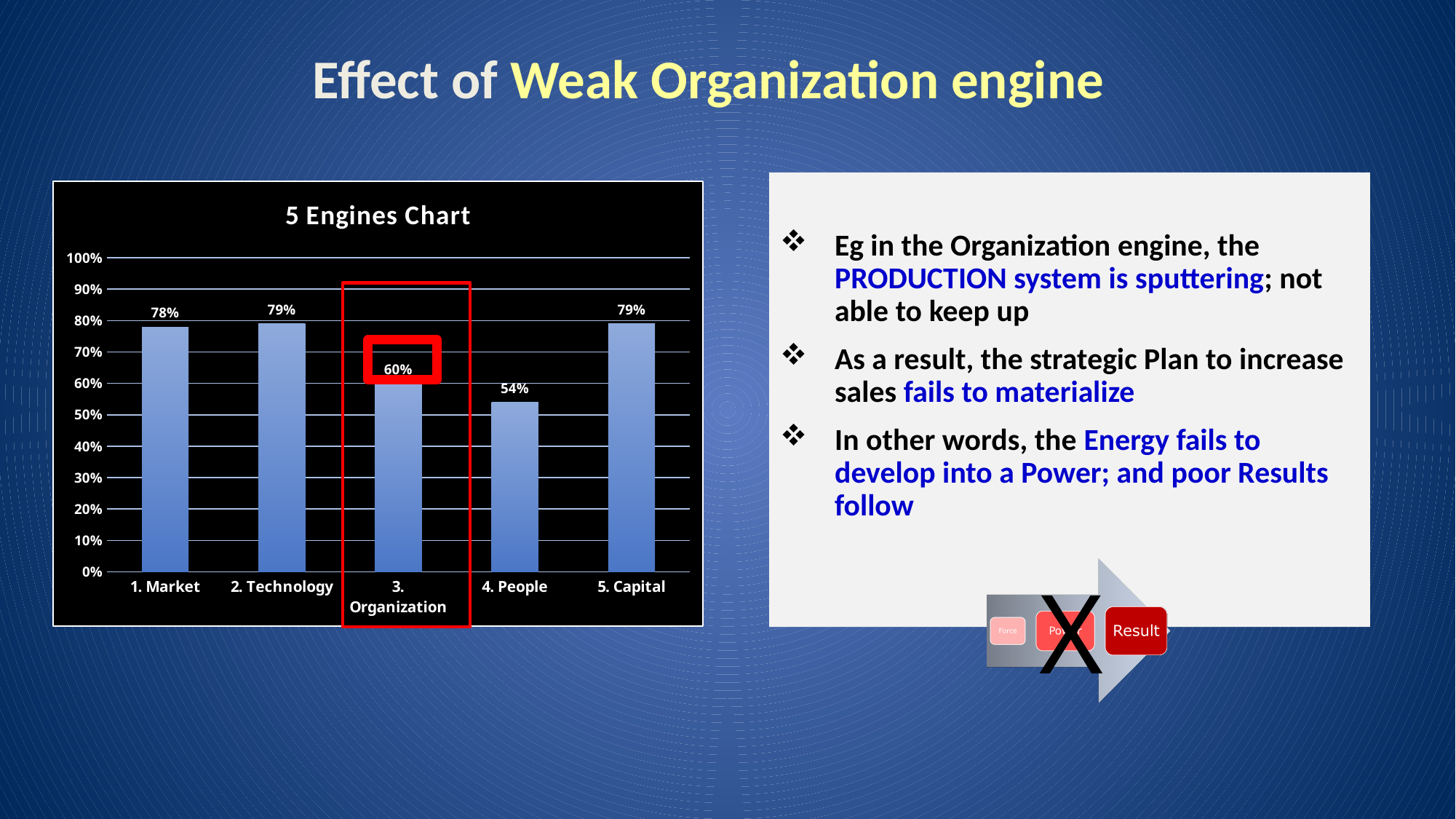
What is the difference between the values for 3. Organization and 4. People? 6% How many categories are shown in the 5 Engines Chart? 5 Which category's bar is outlined with a red box in the chart? 3. Organization What kind of chart is the 5 Engines Chart? bar chart Which is larger, the value for 1. Market or the value for 4. People? 1. Market What is the value for 3. Organization in the 5 Engines Chart? 60% What is the value for 1. Market in the 5 Engines Chart? 78% What is the title of the chart on the slide? 5 Engines Chart Is the value for 5. Capital greater or less than 70%? greater Which category has the lowest value in the 5 Engines Chart? 4. People What is the difference between the values for 2. Technology and 3. Organization? 19% What is the value for 4. People in the 5 Engines Chart? 54%